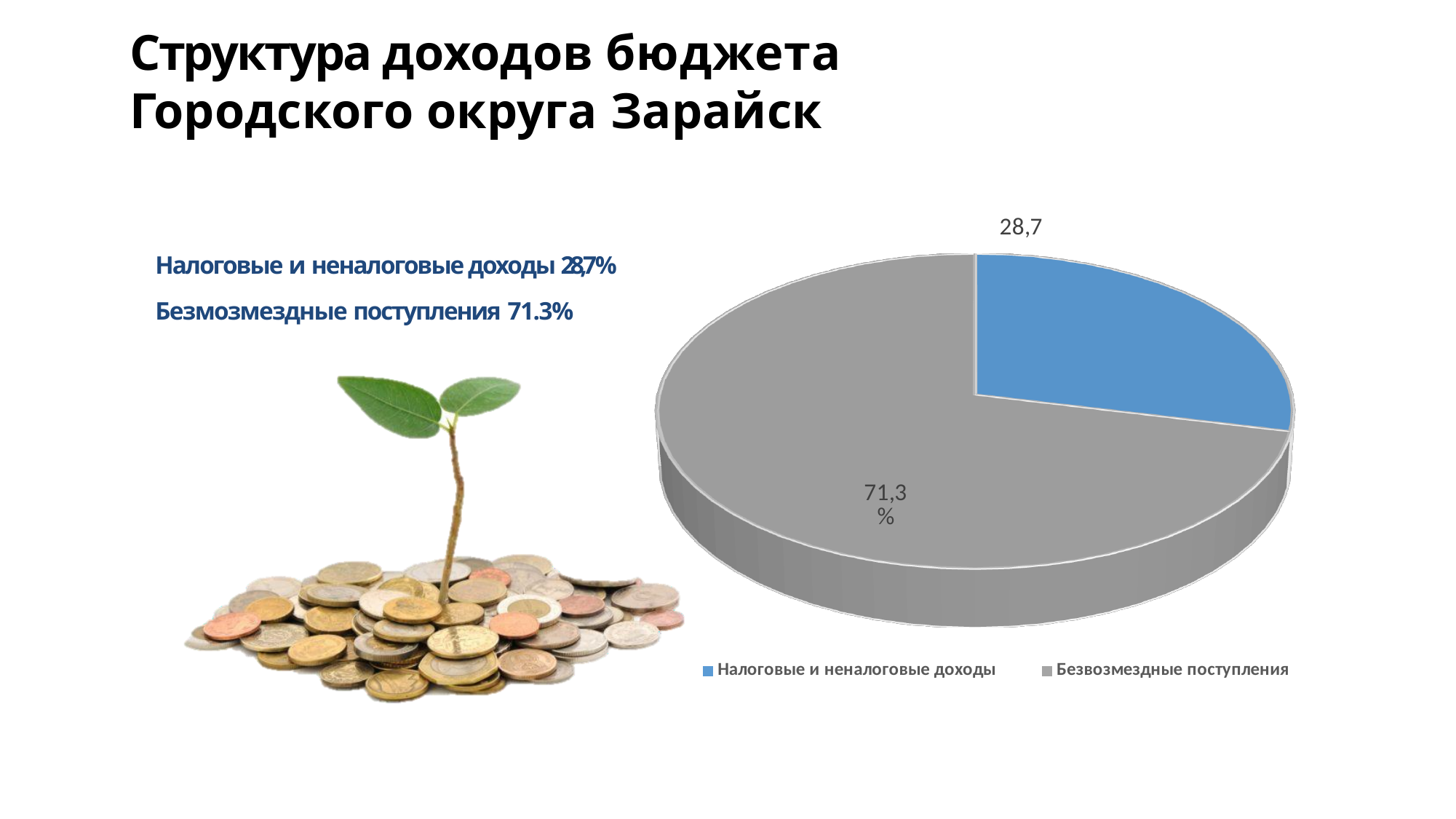
Which slice of the pie is the largest? Безвозмездные поступления What value is labelled on the slice for Безвозмездные поступления? 71,3% What value is labelled on the slice for Налоговые и неналоговые доходы? 28,7 What is the difference in percentage points between Безвозмездные поступления and Налоговые и неналоговые доходы? 42,6 Which slice of the pie is the smallest? Налоговые и неналоговые доходы What kind of chart is shown on the slide? pie chart Which is larger: Налоговые и неналоговые доходы or Безвозмездные поступления? Безвозмездные поступления What colour is the slice for Налоговые и неналоговые доходы? blue How many entries does the legend list? 2 What share of the pie does Безвозмездные поступления take? 71,3% What colour is the slice for Безвозмездные поступления? grey How many slices does the pie chart have? 2